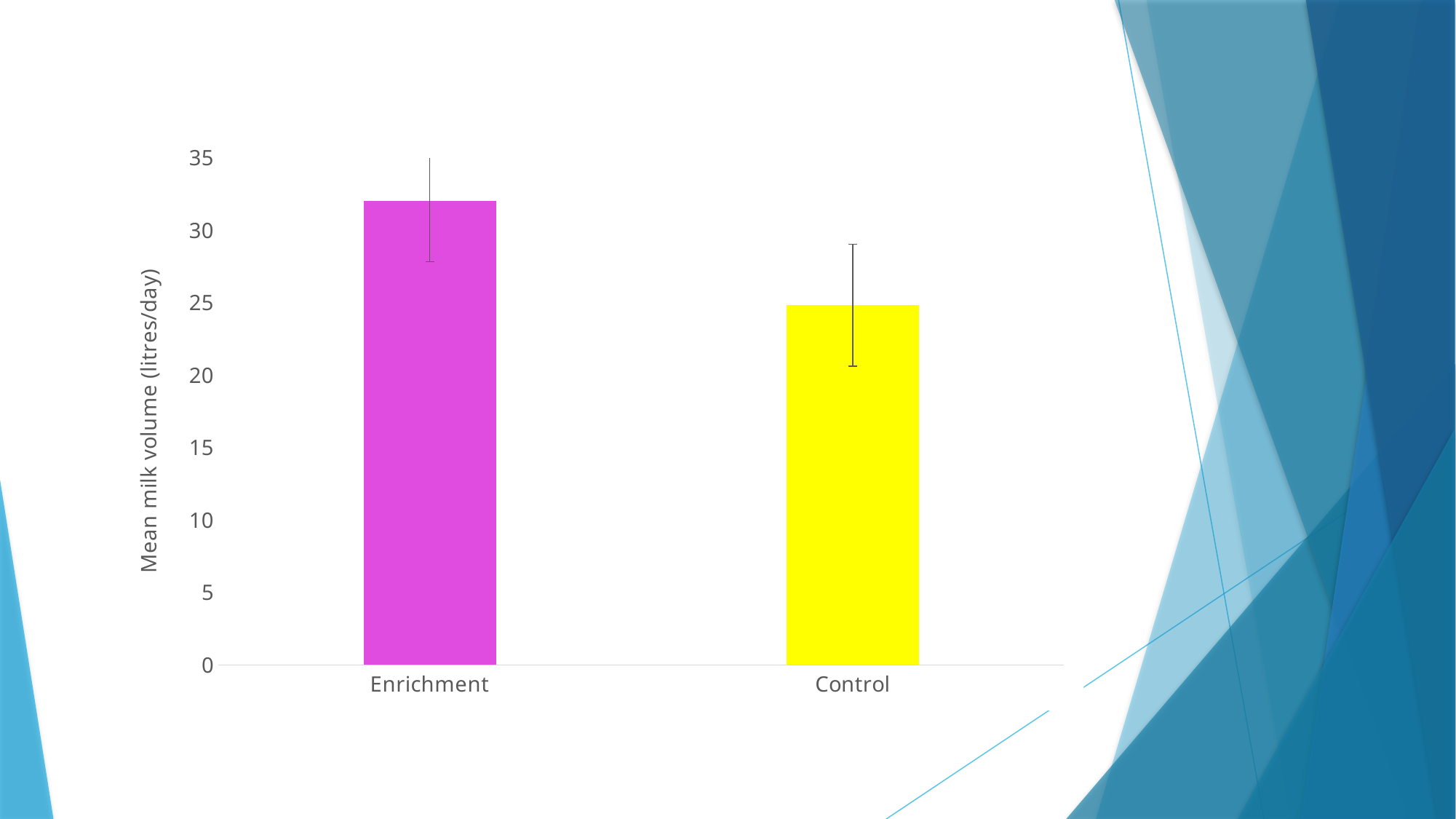
Which category has the lowest mean milk volume? Control Is the value for Enrichment greater or less than 35? less Is the value for Enrichment greater or less than 30? greater What kind of chart is shown on the slide? Bar chart How many categories are plotted on the x axis? 2 Which is larger, the value for Enrichment or the value for Control? Enrichment What colour is the Control bar? Yellow What is the label on the vertical axis? Mean milk volume (litres/day) Is the value for Control greater or less than 20? greater Which category has the highest mean milk volume? Enrichment